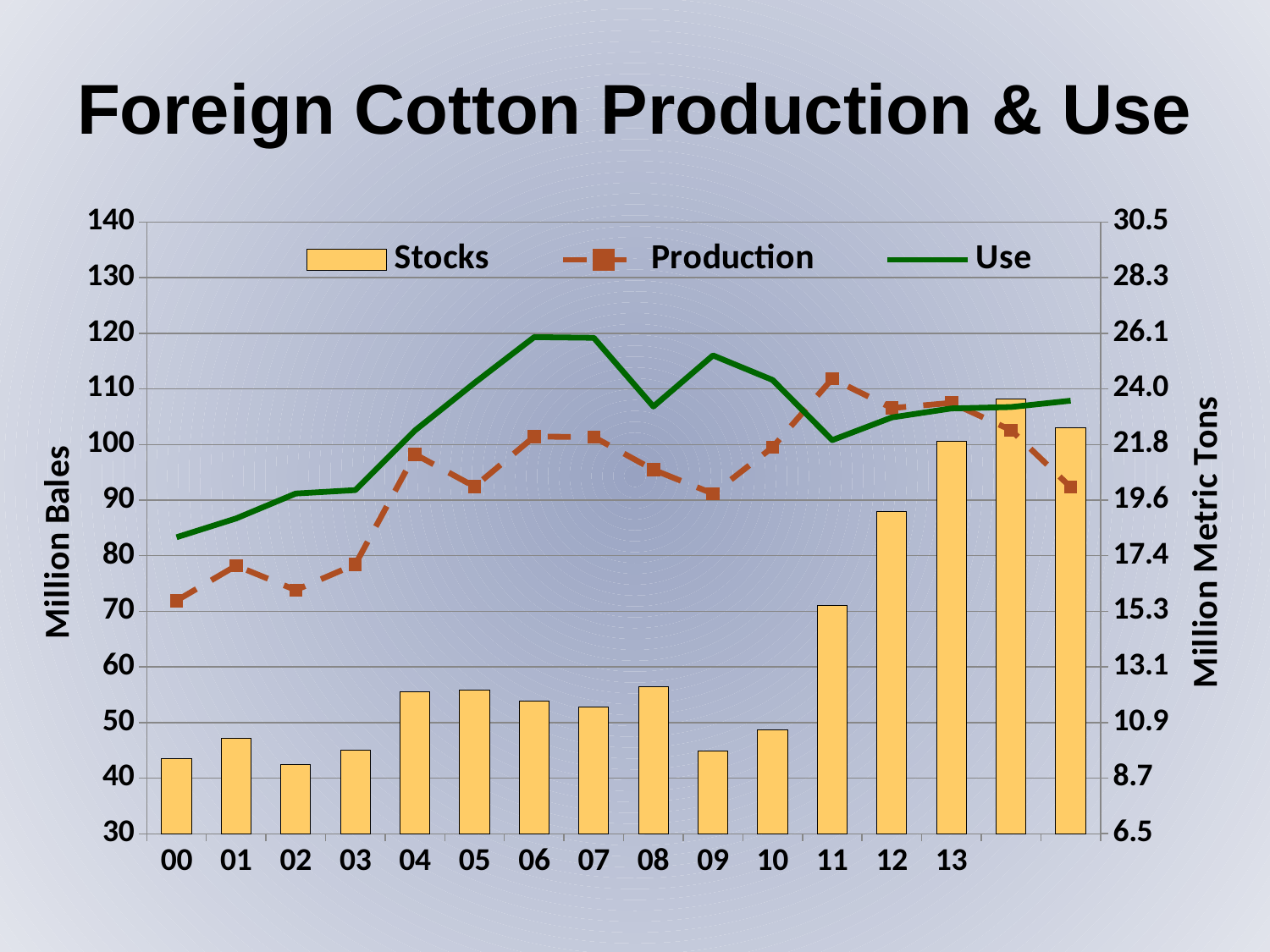
In 11, which is larger, Production or Use? Production Is the Use value for 00 greater or less than 80? greater What is the title of the chart? Foreign Cotton Production & Use In 06, which is larger, Use or Production? Use What kind of chart is this? Combination bar and line chart Is the Stocks value for 05 greater or less than 60? less How many series does the legend list? 3 Do the Stocks bars rise or fall from 09 to 13? rise In which labeled year is Production highest? 11 Is the Stocks value for 12 greater or less than 80? greater What is the label of the left vertical axis? Million Bales